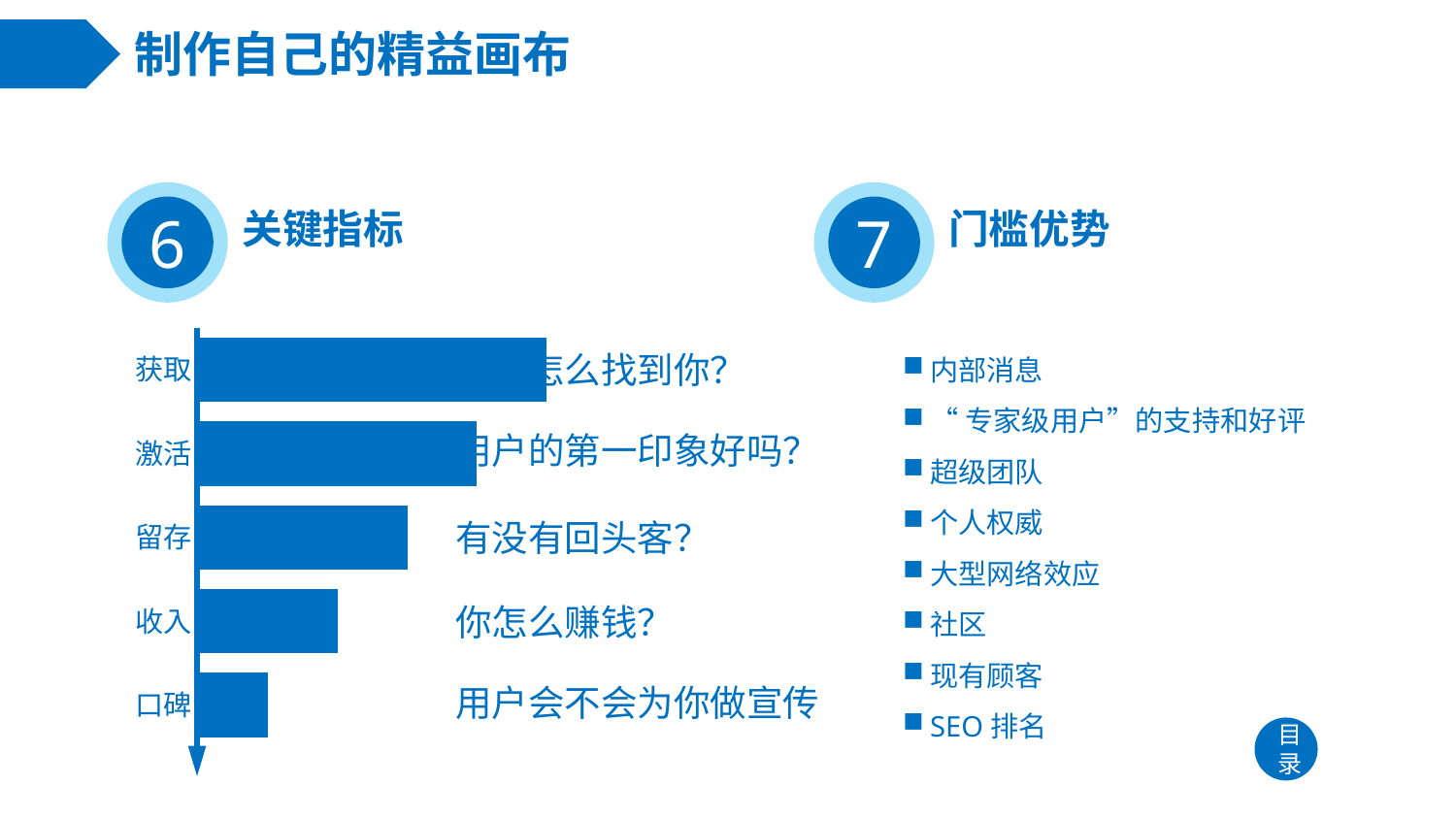
Which category has the shortest bar in the bar chart? 口碑 In the bar chart, which bar is longer: 留存 or 口碑? 留存 Which category is listed first (at the top) in the bar chart? 获取 Which category has the longest bar in the bar chart? 获取 What colour are the bars in the chart? blue In the bar chart, which bar is longer: 获取 or 收入? 获取 In the bar chart, which bar is longer: 收入 or 口碑? 收入 How many categories does the bar chart under 关键指标 show? 5 Do the bars in the chart get longer or shorter going from 获取 at the top down to 口碑 at the bottom? shorter What kind of chart is shown under the heading 关键指标? bar chart Are the bars in the chart drawn horizontally or vertically? horizontally